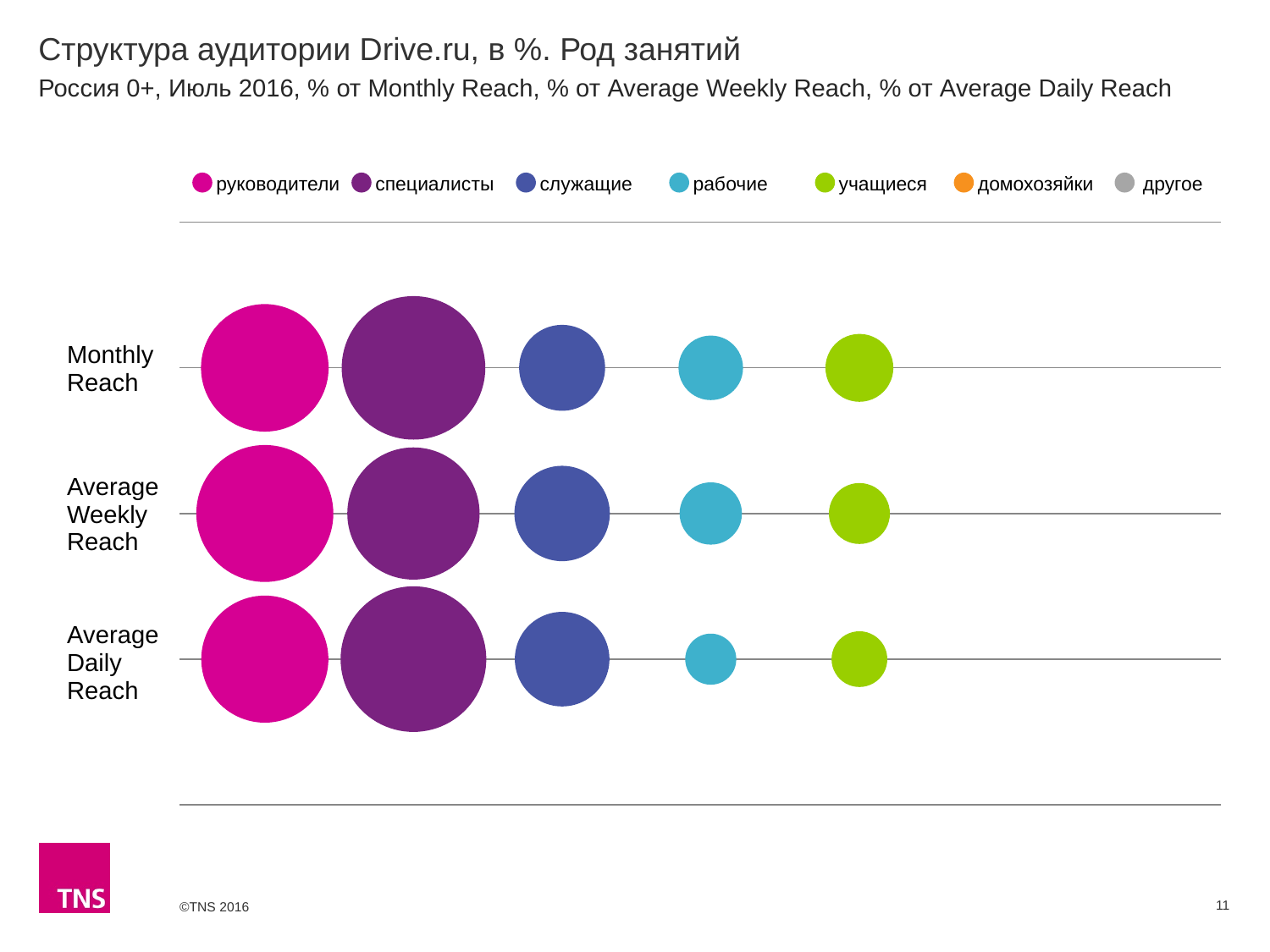
In the Average Weekly Reach row, which bubble is larger: служащие or учащиеся? служащие How many series does the legend list? 7 What kind of chart is shown on the slide? bubble chart How many reach categories (rows) are plotted on the chart? 3 In the Monthly Reach row, which occupation has the largest bubble? специалисты In the Average Daily Reach row, which bubble is larger: руководители or рабочие? руководители Which legend entries have no visible bubble in any row of the chart? домохозяйки and другое In the Average Daily Reach row, which occupation has the smallest visible bubble? рабочие In the Monthly Reach row, which bubble is larger: специалисты or служащие? специалисты What is the title of the chart on the slide? Структура аудитории Drive.ru, в %. Род занятий